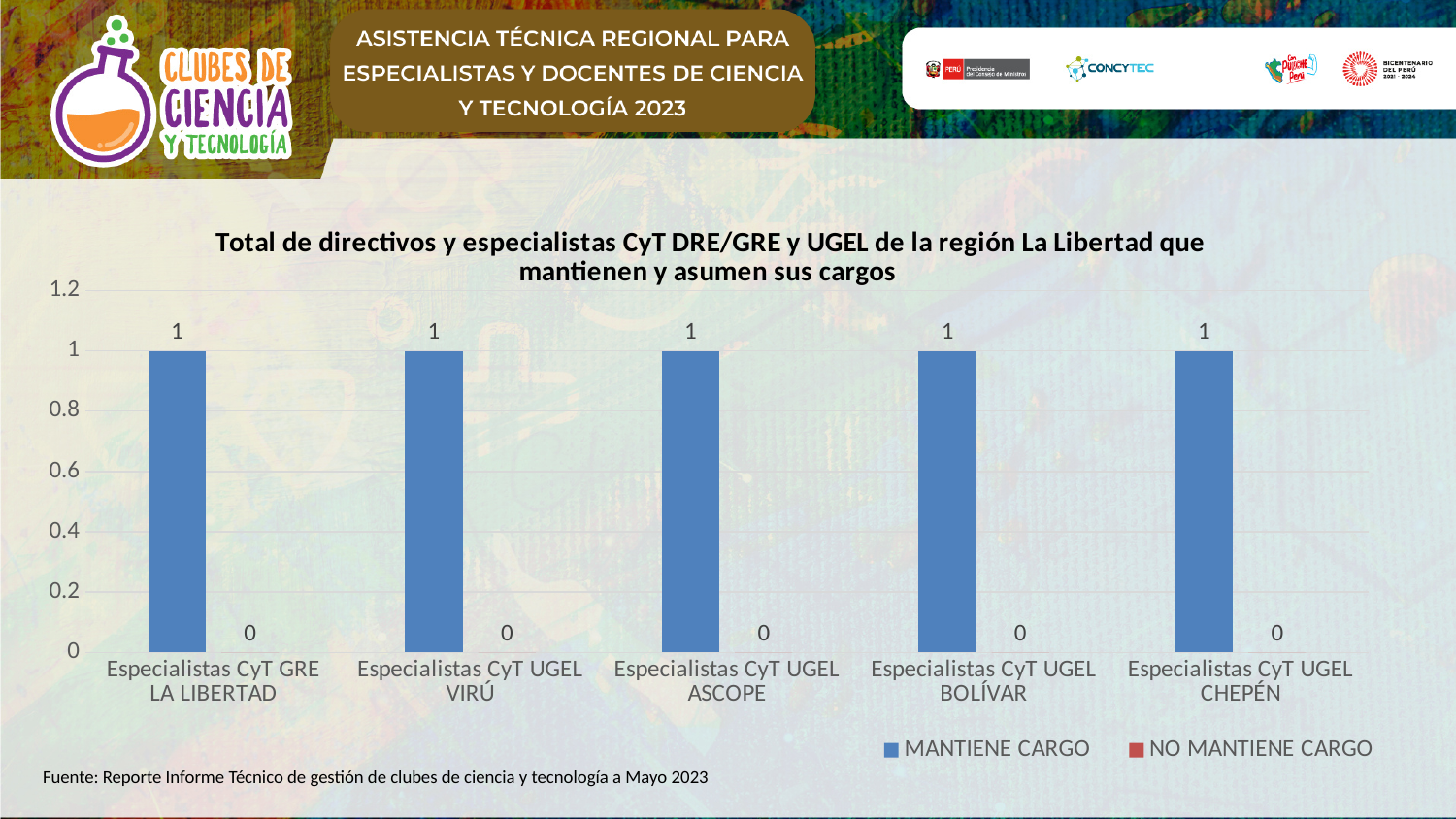
How many categories are shown on the x axis of the chart? 5 How many series does the chart legend list? 2 What is the MANTIENE CARGO value for Especialistas CyT GRE LA LIBERTAD? 1 What is the NO MANTIENE CARGO value for Especialistas CyT UGEL VIRÚ? 0 What is the NO MANTIENE CARGO value for Especialistas CyT UGEL BOLÍVAR? 0 What is the title of the chart? Total de directivos y especialistas CyT DRE/GRE y UGEL de la región La Libertad que mantienen y asumen sus cargos Which series is shown in blue in the chart legend? MANTIENE CARGO What kind of chart is shown on the slide? Bar chart What is the MANTIENE CARGO value for Especialistas CyT UGEL CHEPÉN? 1 What is the difference between the MANTIENE CARGO and NO MANTIENE CARGO values for Especialistas CyT UGEL VIRÚ? 1 What is the total of the MANTIENE CARGO values across all five categories? 5 For Especialistas CyT UGEL ASCOPE, which is larger: MANTIENE CARGO or NO MANTIENE CARGO? MANTIENE CARGO